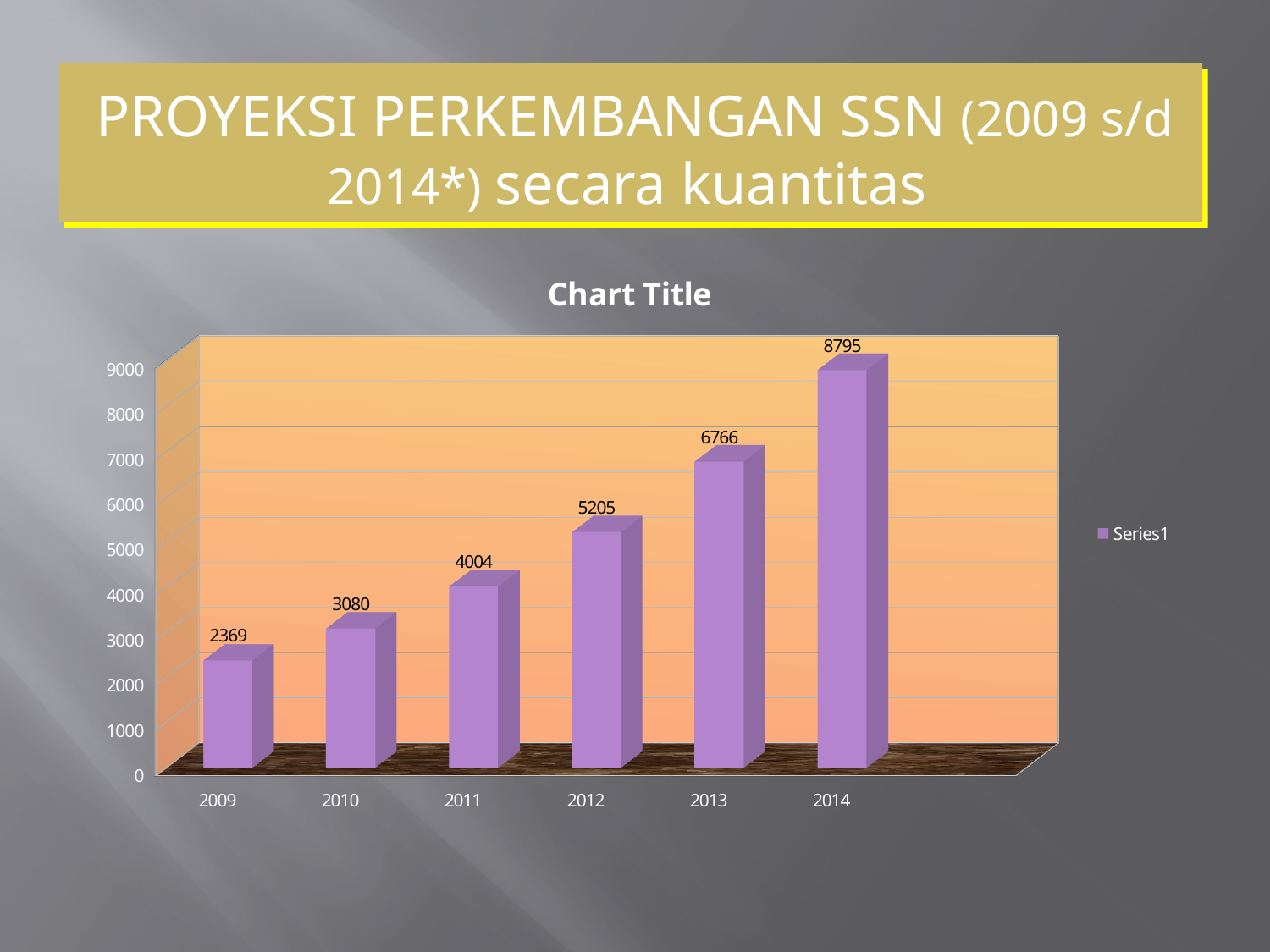
What is the difference between the values for 2013 and 2012? 1561 How many years are shown on the x axis? 6 Which year has the lowest value? 2009 What is the value for 2014? 8795 What is the value for 2009? 2369 Which year has the highest value? 2014 What is the value for 2012? 5205 Is the value for 2013 greater or less than 7000? less What kind of chart is shown? bar chart Do the values rise or fall from 2009 to 2014? rise Which is larger, the value for 2011 or the value for 2010? 2011 What is the difference between the values for 2014 and 2009? 6426